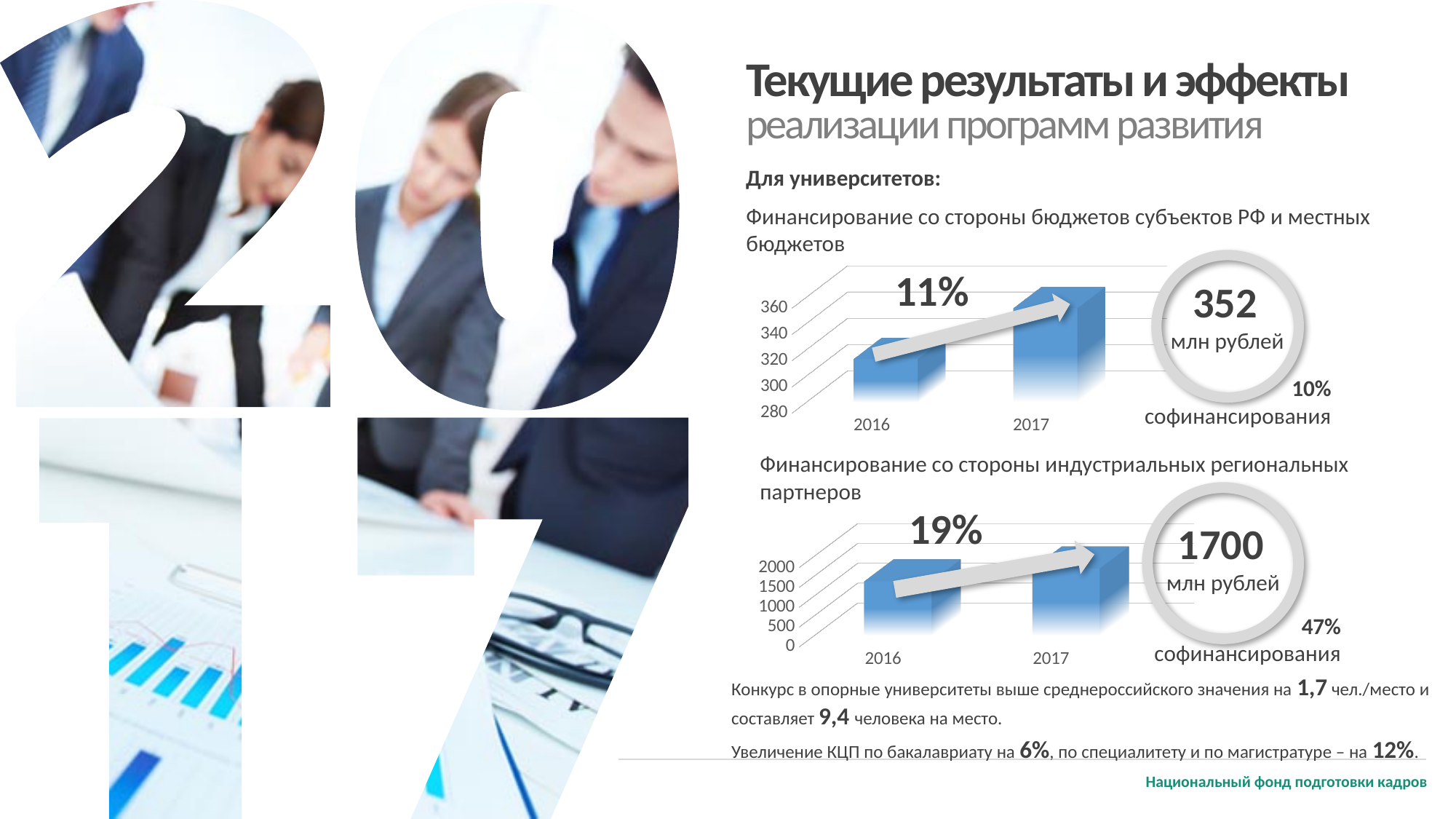
In the top chart, which year has the higher bar, 2016 or 2017? 2017 In the top chart, is the value for 2017 greater or less than 340? greater How many categories are shown on the x axis of the top chart? 2 What percentage growth is annotated on the bottom chart? 19% What kind of chart is the top chart (Финансирование со стороны бюджетов субъектов РФ и местных бюджетов)? bar chart In the bottom chart, do the values rise or fall from 2016 to 2017? rise What kind of chart is the bottom chart (Финансирование со стороны индустриальных региональных партнеров)? bar chart In the top chart, do the values rise or fall from 2016 to 2017? rise How many bars does the bottom chart have? 2 In the bottom chart, is the value for 2016 greater or less than 2000? less What percentage growth is annotated on the top chart? 11% In the bottom chart, which year has the lower bar? 2016